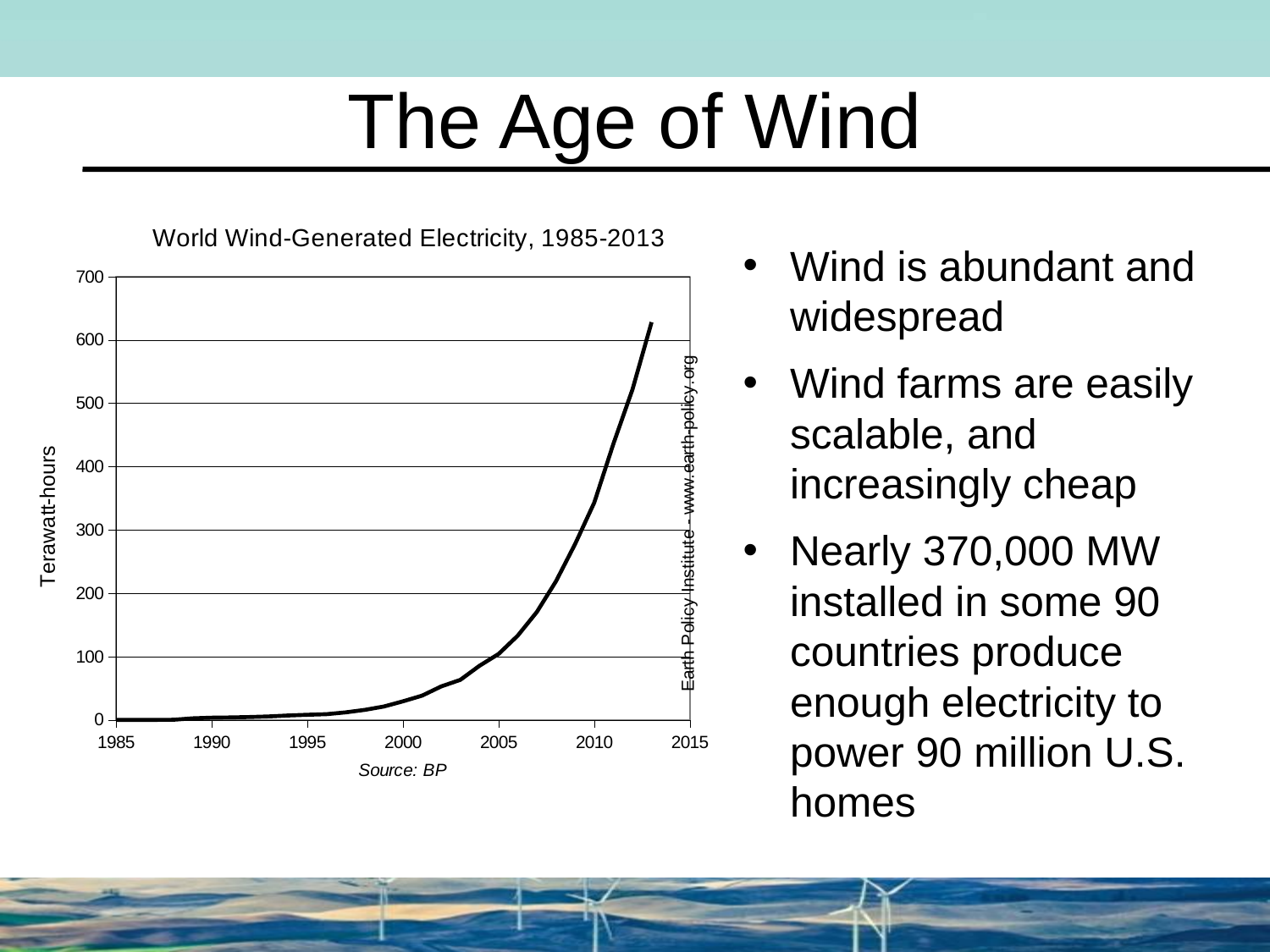
Is the value for 2000 greater or less than 100 terawatt-hours? less Which year shown has the highest wind-generated electricity? 2013 Is the value for 2010 greater or less than 200 terawatt-hours? greater What is the highest value shown on the vertical axis of the chart? 700 Is the value for 2013 greater or less than 500 terawatt-hours? greater Which is larger, the value for 2010 or the value for 2005? 2010 What is the title of the chart? World Wind-Generated Electricity, 1985-2013 What kind of chart is shown on the slide? line chart Do the values in the chart rise or fall from 1985 to 2013? rise What unit is shown on the vertical axis of the chart? Terawatt-hours